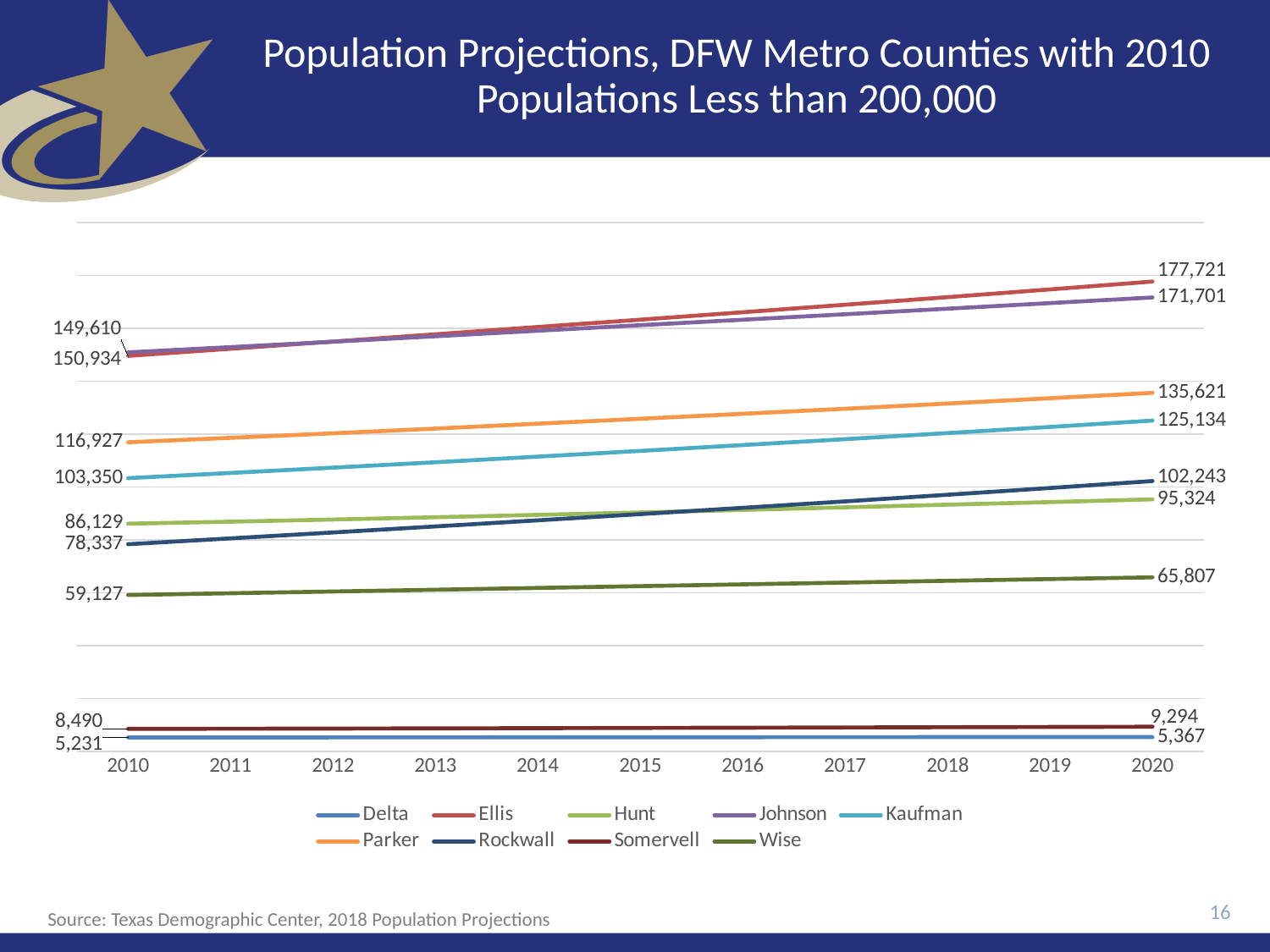
How many years are shown along the x axis? 11 By how much does Rockwall's population increase from 2010 to 2020? 23,906 What is the projected population for Parker in 2020? 135,621 Which has the larger projected population in 2020, Rockwall or Hunt? Rockwall What kind of chart is shown on the slide? line chart What is the projected population for Wise in 2020? 65,807 What is the population for Kaufman in 2010? 103,350 Which county has the lowest projected population in 2020? Delta What is the population for Delta in 2010? 5,231 Which county has the highest projected population in 2020? Ellis What is the projected population for Somervell in 2020? 9,294 How many series does the legend list? 9